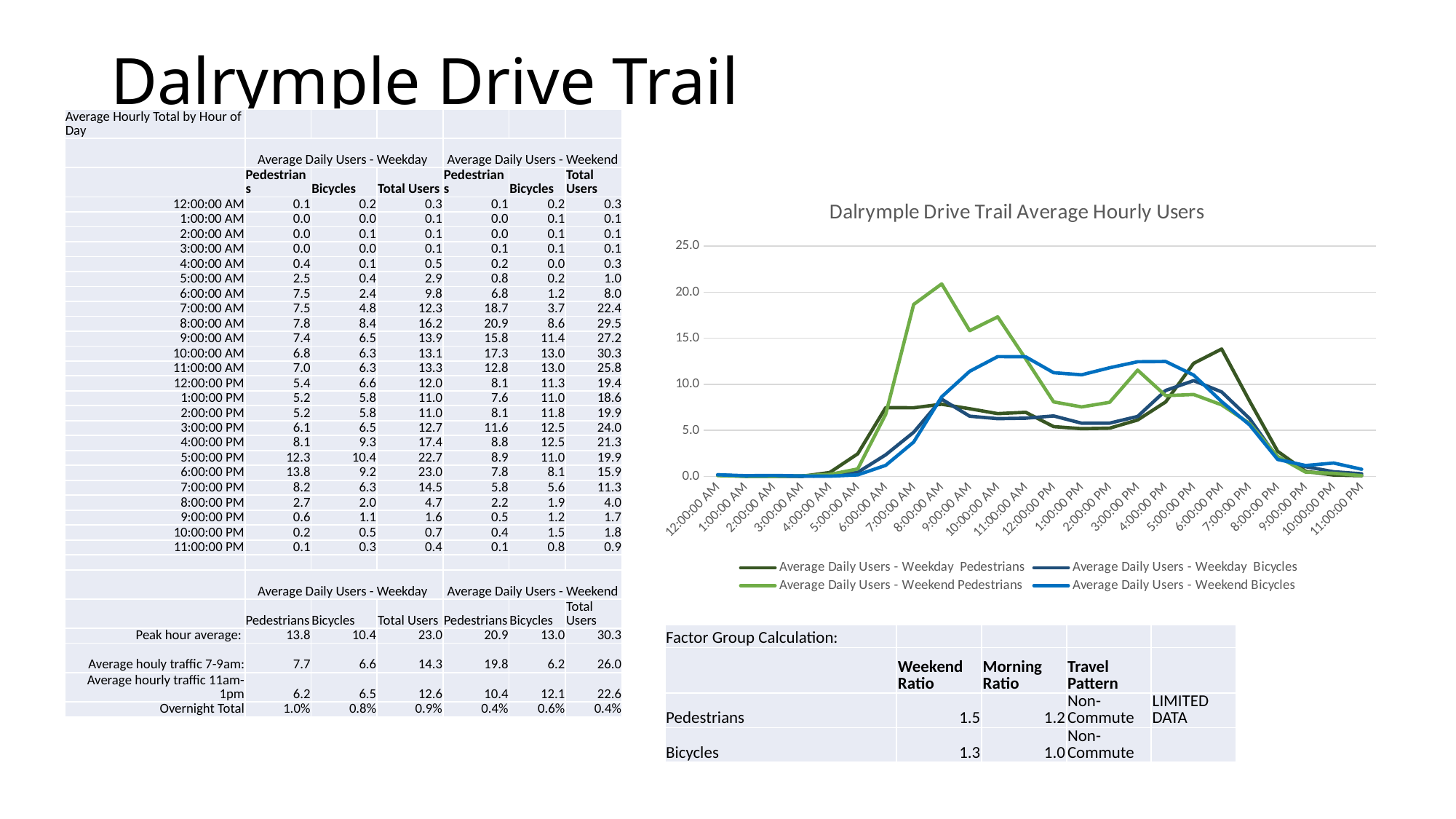
What kind of chart is shown on the slide? line chart What is the title of the chart on the slide? Dalrymple Drive Trail Average Hourly Users How many series does the chart's legend list? 4 At which hour does the Weekday Pedestrians series reach its peak? 6:00:00 PM Is the value for Weekday Pedestrians at 6:00:00 PM greater or less than 15.0? less At which hour does the Weekend Pedestrians series reach its peak? 8:00:00 AM Is the value for Weekend Pedestrians at 8:00:00 AM greater or less than 15.0? greater At 6:00:00 PM, which is larger: Weekday Pedestrians or Weekend Pedestrians? Weekday Pedestrians At 8:00:00 AM, which is larger: Weekend Pedestrians or Weekday Pedestrians? Weekend Pedestrians How many hourly categories are shown along the x axis of the chart? 24 Does the Weekday Pedestrians series rise or fall from 2:00:00 PM to 6:00:00 PM? rise Which series reaches the highest value on the chart? Average Daily Users - Weekend Pedestrians